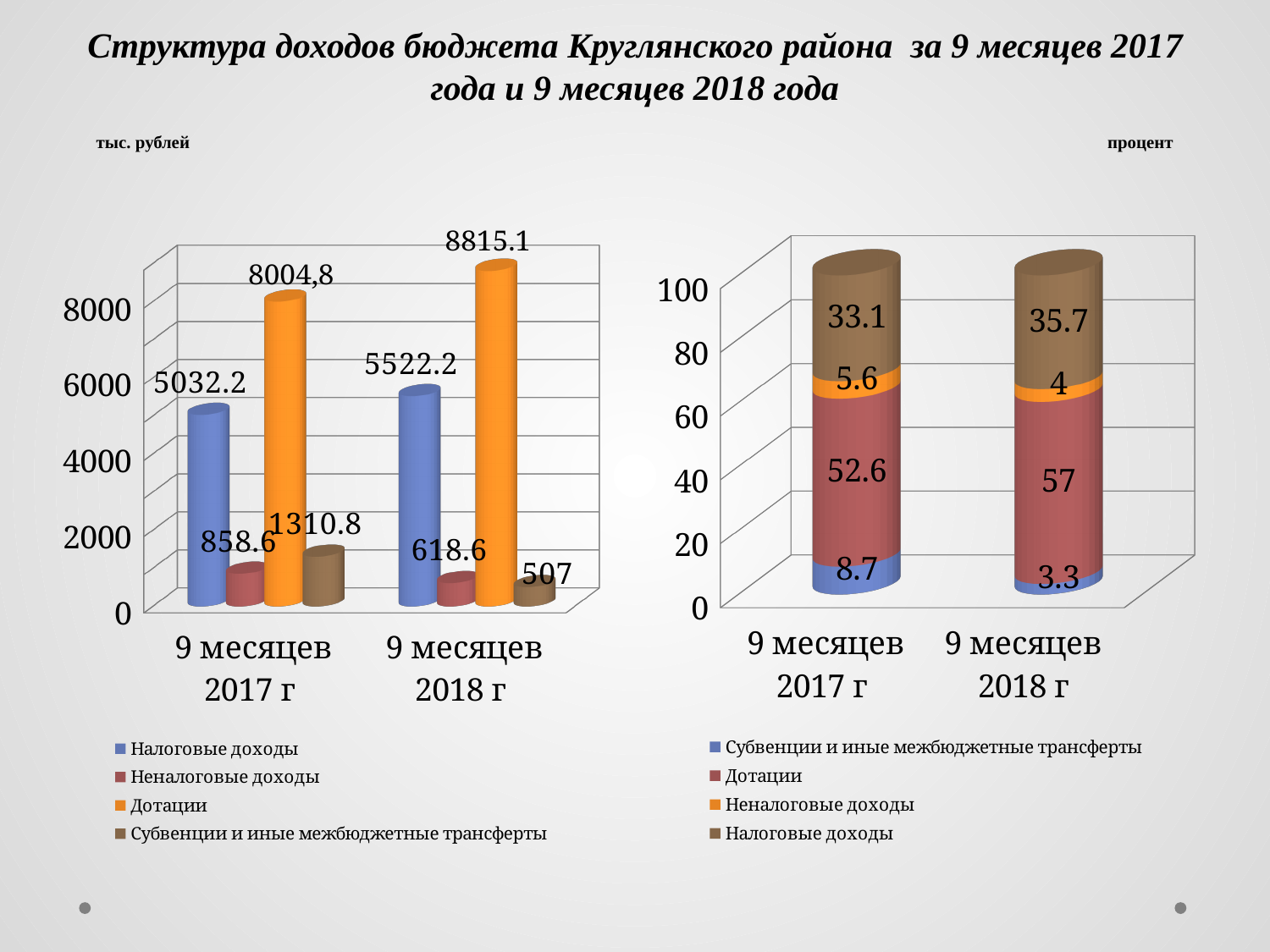
What kind of chart is the right chart (процент)? Stacked bar chart On the left chart (тыс. рублей), how many series does the legend list? 4 On the right chart (процент), what is the share of Субвенции и иные межбюджетные трансферты for 9 месяцев 2017 г? 8.7 On the left chart (тыс. рублей), which series has the lowest value for 9 месяцев 2018 г? Субвенции и иные межбюджетные трансферты On the right chart (процент), what is the difference between Налоговые доходы for 9 месяцев 2018 г and 9 месяцев 2017 г? 2.6 On the left chart (тыс. рублей), what is the value of Дотации for 9 месяцев 2018 г? 8815.1 On the left chart (тыс. рублей), which series has the highest value for 9 месяцев 2017 г? Дотации On the left chart (тыс. рублей), is Неналоговые доходы larger for 9 месяцев 2017 г or 9 месяцев 2018 г? 9 месяцев 2017 г On the left chart (тыс. рублей), what is the difference between Налоговые доходы for 9 месяцев 2018 г and 9 месяцев 2017 г? 490 On the left chart (тыс. рублей), what is the value of Налоговые доходы for 9 месяцев 2017 г? 5032.2 On the left chart (тыс. рублей), what is the value of Субвенции и иные межбюджетные трансферты for 9 месяцев 2018 г? 507 On the right chart (процент), what is the share of Дотации for 9 месяцев 2018 г? 57